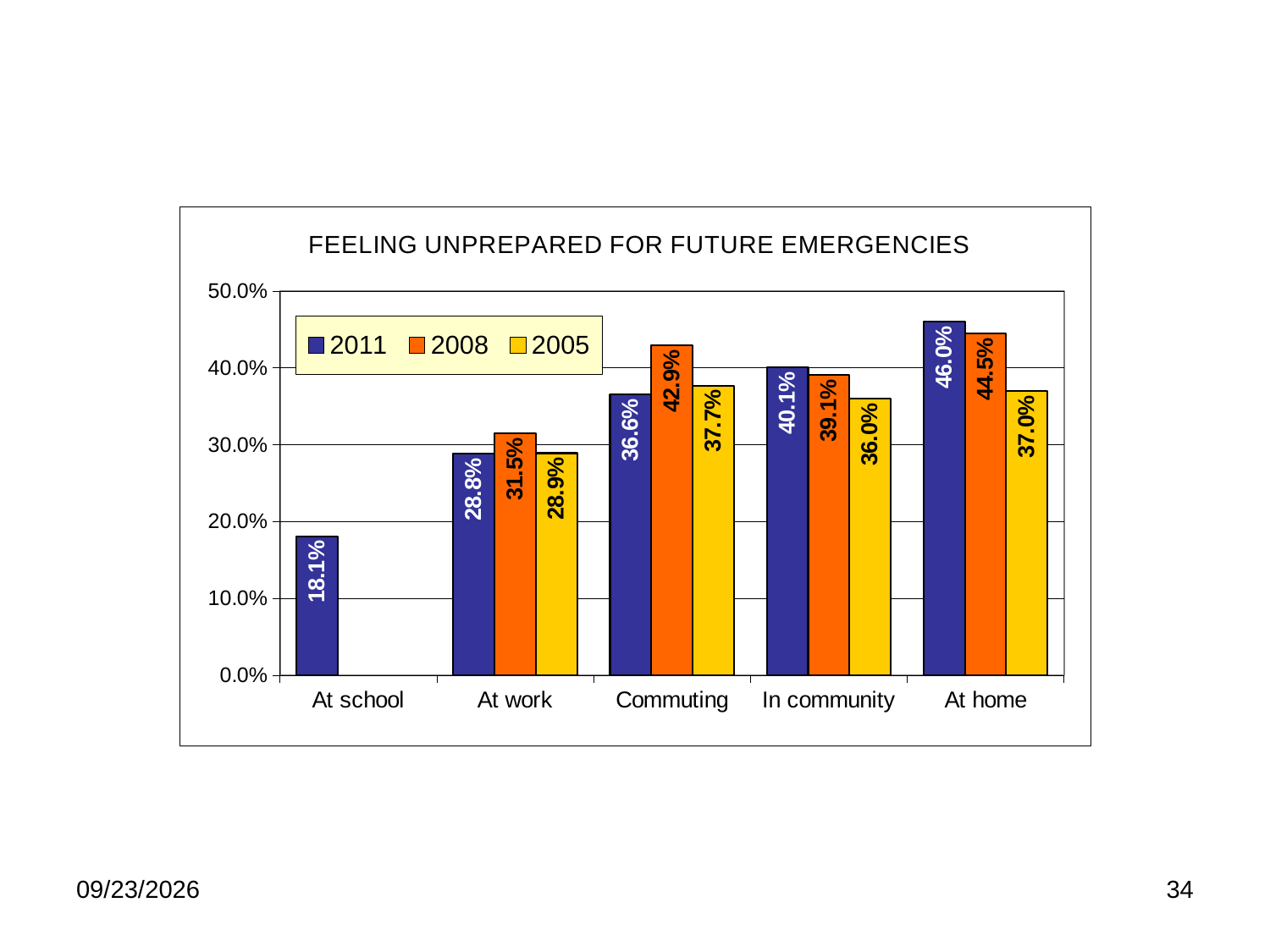
What is the 2011 value for At school? 18.1% What is the title of the chart? FEELING UNPREPARED FOR FUTURE EMERGENCIES How many series does the legend list? 3 What is the 2008 value for Commuting? 42.9% Which is larger for At work: the 2008 value or the 2005 value? 2008 Which category has the highest 2011 value? At home How many categories are shown on the x axis? 5 What is the 2005 value for In community? 36.0% What kind of chart is shown? Bar chart What is the 2011 value for At home? 46.0% Which category has the lowest 2011 value? At school What is the difference between the 2011 and 2008 values for Commuting? 6.3%